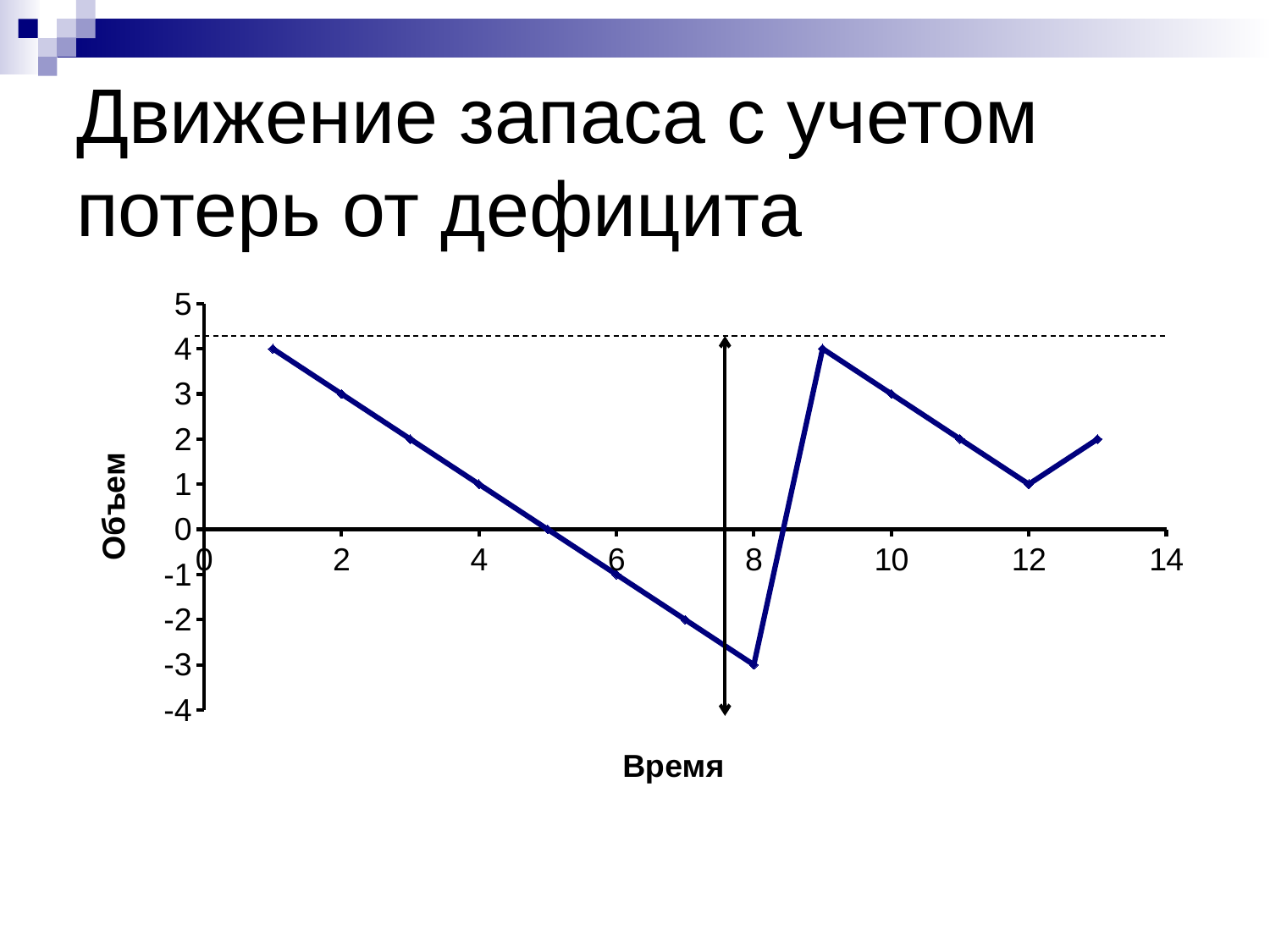
What kind of chart is shown on the slide? line chart What is the value (Объем) at time 8? -3 Is the value at time 8 greater or less than 0? less What is the difference between the value at time 2 and the value at time 12? 2 What is the value (Объем) at time 6? -1 What is the value (Объем) at time 2? 3 What is the highest value plotted on the chart? 4 What is the lowest value plotted on the chart? -3 At which time does the line reach its lowest value? 8 Does the line rise or fall between time 1 and time 8? fall Which is larger: the value at time 2 or the value at time 6? time 2 What is the value (Объем) at time 12? 1